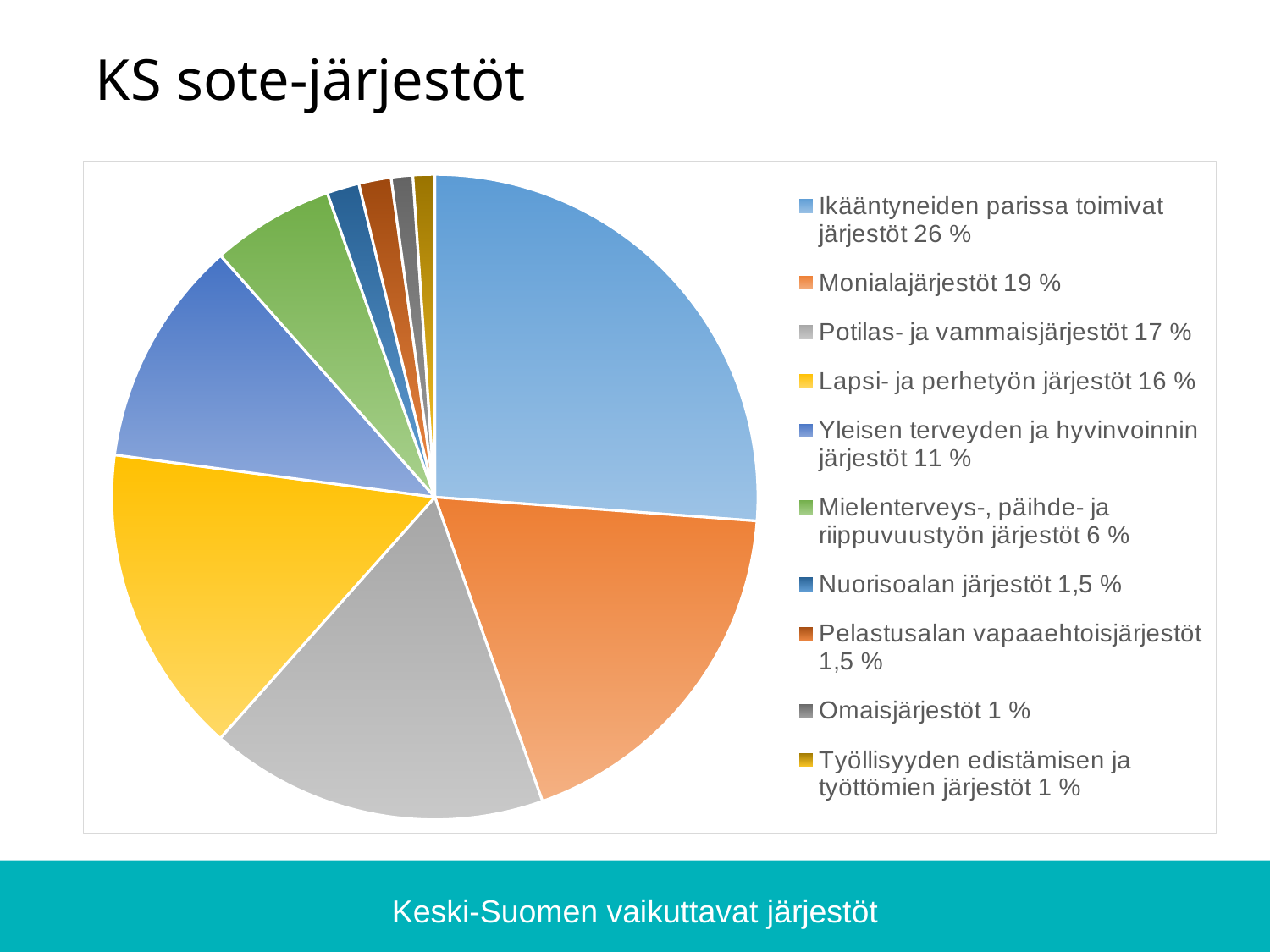
What is the difference in percentage points between Ikääntyneiden parissa toimivat järjestöt and Monialajärjestöt? 7 What percentage is shown for Yleisen terveyden ja hyvinvoinnin järjestöt? 11 % How many categories does the pie chart have? 10 What percentage is shown for Nuorisoalan järjestöt? 1,5 % What colour is the slice for Lapsi- ja perhetyön järjestöt? yellow What percentage is shown for Lapsi- ja perhetyön järjestöt? 16 % What kind of chart is shown on the slide? pie chart What share of the pie do Monialajärjestöt have? 19 % What is the title of the slide containing the chart? KS sote-järjestöt What percentage is shown for Potilas- ja vammaisjärjestöt? 17 % Which has a larger share: Mielenterveys-, päihde- ja riippuvuustyön järjestöt or Omaisjärjestöt? Mielenterveys-, päihde- ja riippuvuustyön järjestöt Which category has the largest share of the pie? Ikääntyneiden parissa toimivat järjestöt